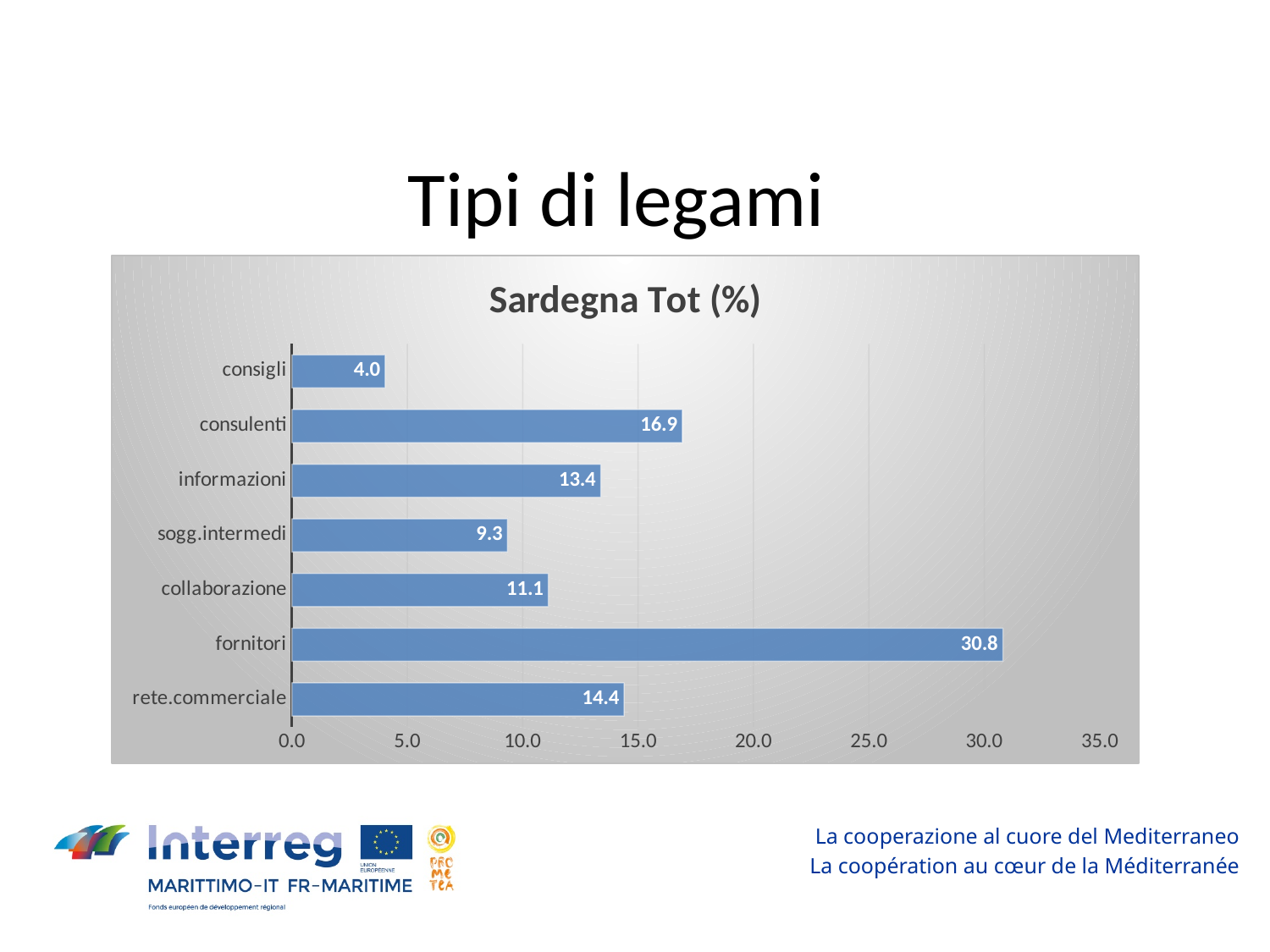
What is the value for fornitori? 30.8 What is the title of the chart? Sardegna Tot (%) What is the value for rete.commerciale? 14.4 Which category has the lowest value? consigli What is the difference between the values for consulenti and informazioni? 3.5 What kind of chart is shown on the slide? bar chart What is the value for sogg.intermedi? 9.3 Which is larger, the value for collaborazione or the value for sogg.intermedi? collaborazione How many categories are shown in the chart? 7 Which category has the highest value? fornitori What is the value for consigli? 4.0 Is the value for fornitori greater or less than 25.0? greater